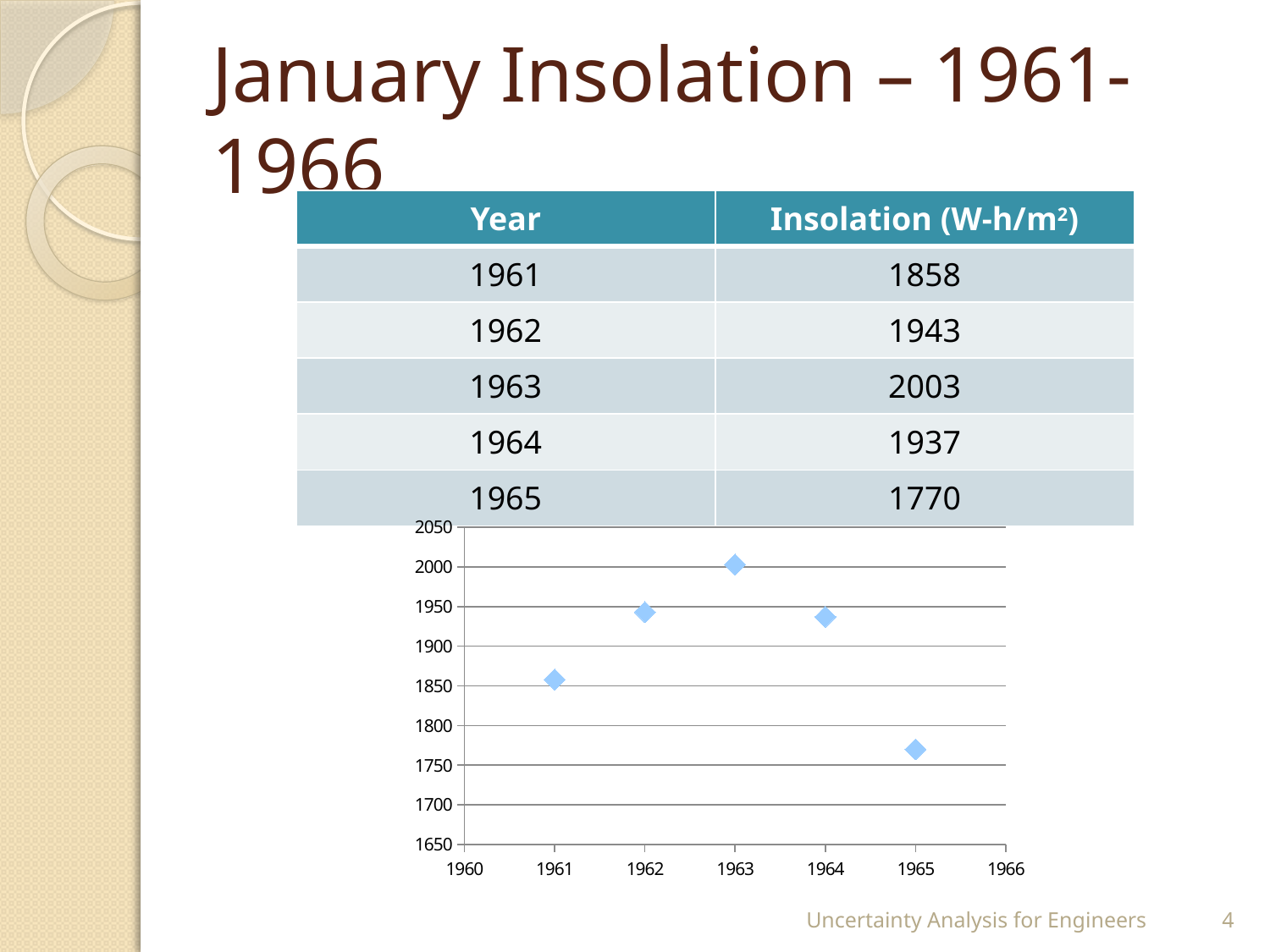
Which year has the lowest insolation value in the chart? 1965 Which year has the larger insolation value, 1961 or 1962? 1962 What kind of chart is shown on the slide? scatter chart How many data points are plotted in the chart? 5 Which year has the highest insolation value in the chart? 1963 What is the insolation value for 1965? 1770 Do the plotted values rise or fall from 1963 to 1965? fall Is the plotted value for 1965 greater or less than 1800? less What is the insolation value for 1961? 1858 Is the plotted value for 1963 greater or less than 2000? greater What is the insolation value for 1963? 2003 What is the difference between the insolation values for 1963 and 1965? 233